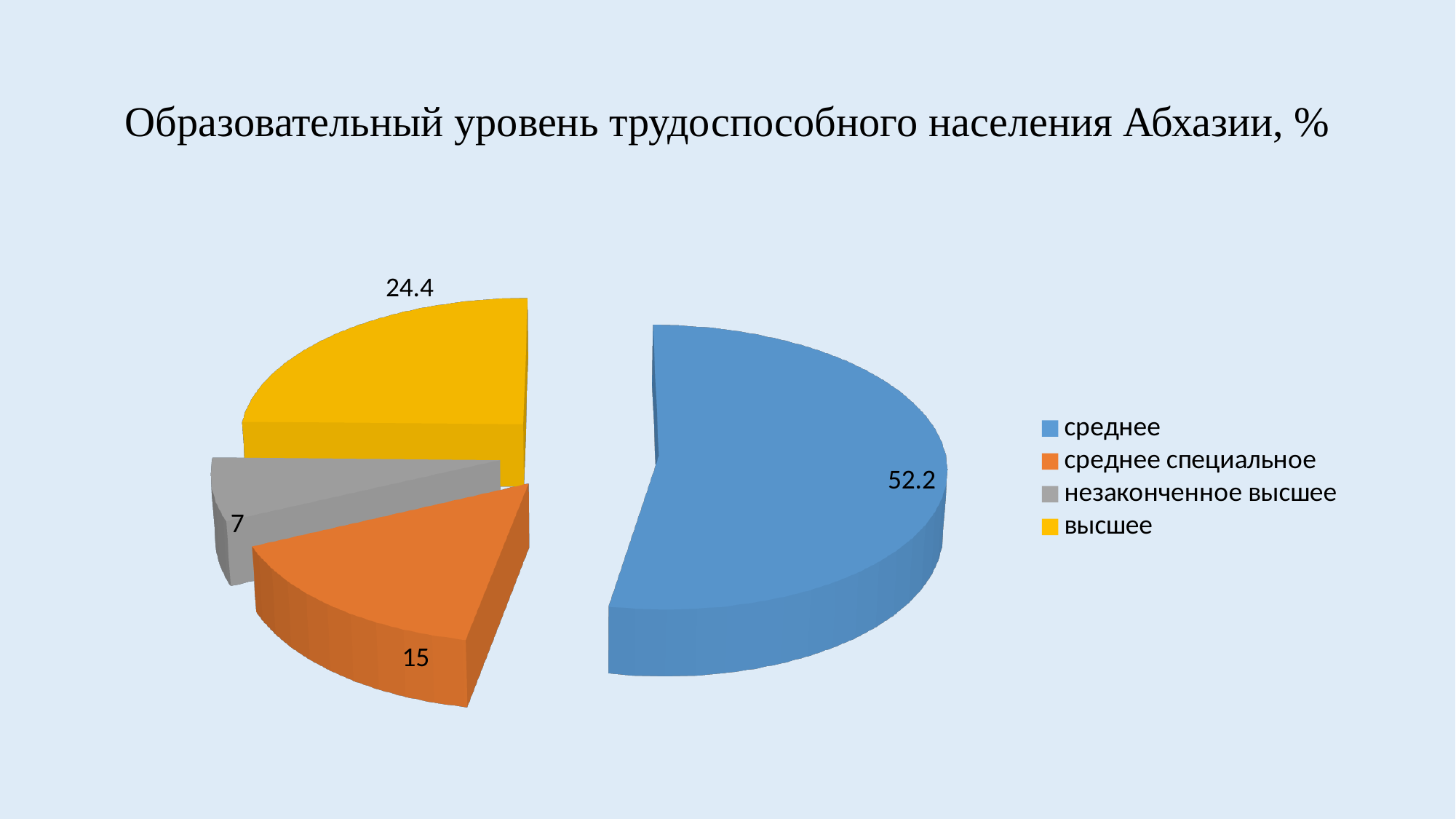
What is the value for среднее специальное? 15 What is the value for незаконченное высшее? 7 What kind of chart is shown on the slide? pie chart Which category has the smallest slice? незаконченное высшее What is the value for среднее? 52.2 Which is larger, высшее or среднее специальное? высшее What is the title of the chart? Образовательный уровень трудоспособного населения Абхазии, % How many slices does the pie chart have? 4 What is the difference between the values for среднее специальное and незаконченное высшее? 8 What is the value for высшее? 24.4 Which category has the largest slice? среднее What is the difference between the values for среднее and высшее? 27.8